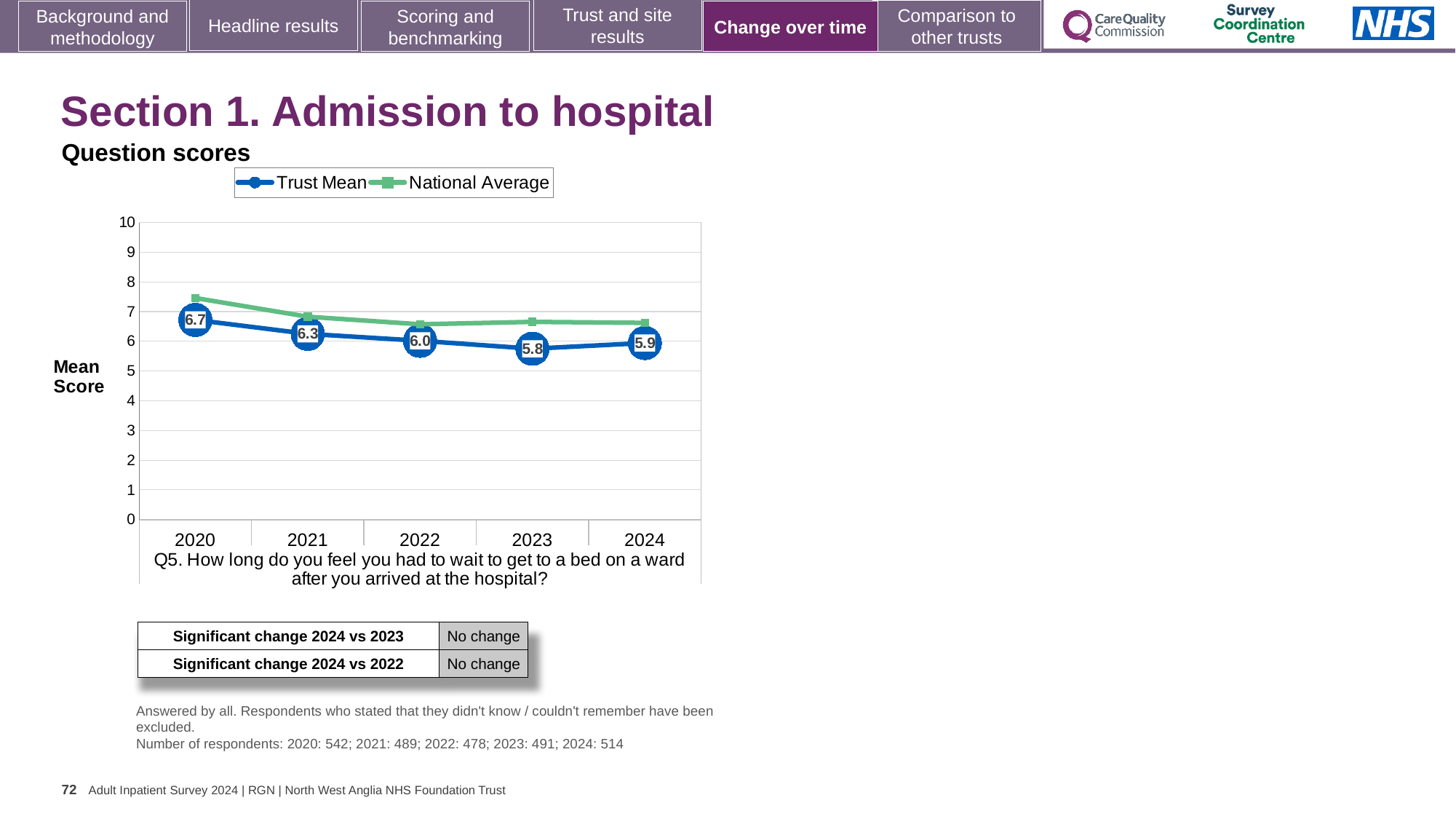
Does the Trust Mean score rise or fall from 2020 to 2023? fall How many years are shown on the x axis? 5 In which year is the Trust Mean score lowest? 2023 How many series does the legend list? 2 What is the Trust Mean score for 2020? 6.7 In which year is the Trust Mean score highest? 2020 What is the Trust Mean score for 2023? 5.8 What kind of chart is shown? line chart What is the difference between the Trust Mean scores for 2020 and 2024? 0.8 Which is larger, the Trust Mean score for 2021 or for 2022? 2021 What is the Trust Mean score for 2024? 5.9 Is the National Average value for 2020 greater or less than 7? greater